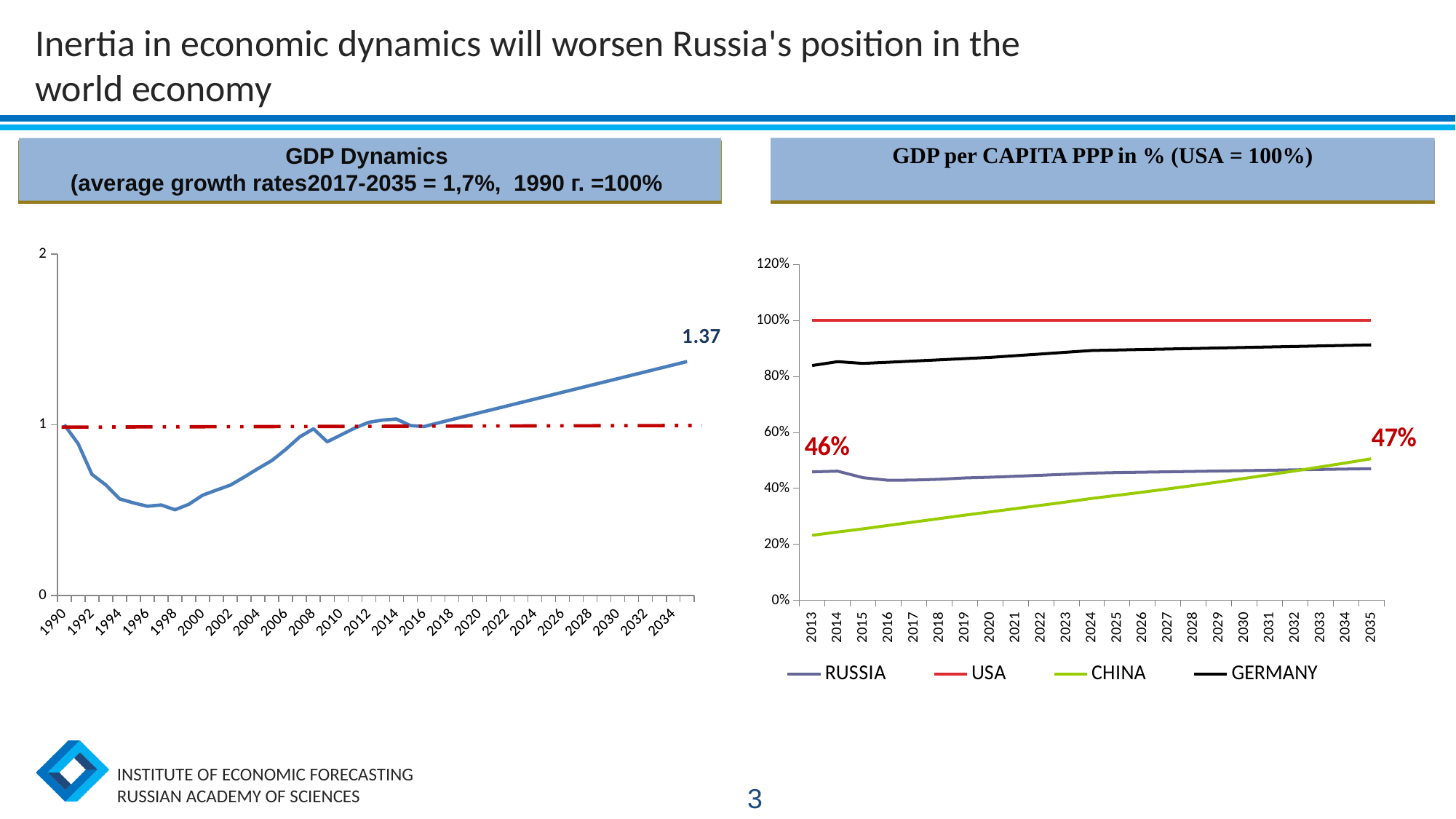
On the GDP Dynamics chart (left), what value is labelled at the end of the line in 2035? 1.37 On the GDP per CAPITA PPP chart (right), what value is labelled for RUSSIA in 2013? 46% On the GDP Dynamics chart (left), is the value for 1998 greater or less than 1? less On the GDP per CAPITA PPP chart (right), is the value for CHINA in 2013 greater or less than 40%? less On the GDP Dynamics chart (left), is the value for 2030 greater or less than 1? greater On the GDP Dynamics chart (left), do the values rise or fall between 2016 and 2034? rise On the GDP per CAPITA PPP chart (right), do the values for CHINA rise or fall from 2013 to 2035? rise What kind of chart is the GDP Dynamics chart on the left? line chart On the GDP per CAPITA PPP chart (right), what value is labelled at the 2035 end of the chart? 47% On the GDP per CAPITA PPP chart (right), which is larger in 2013: GERMANY or CHINA? GERMANY On the GDP per CAPITA PPP chart (right), how many series does the legend list? 4